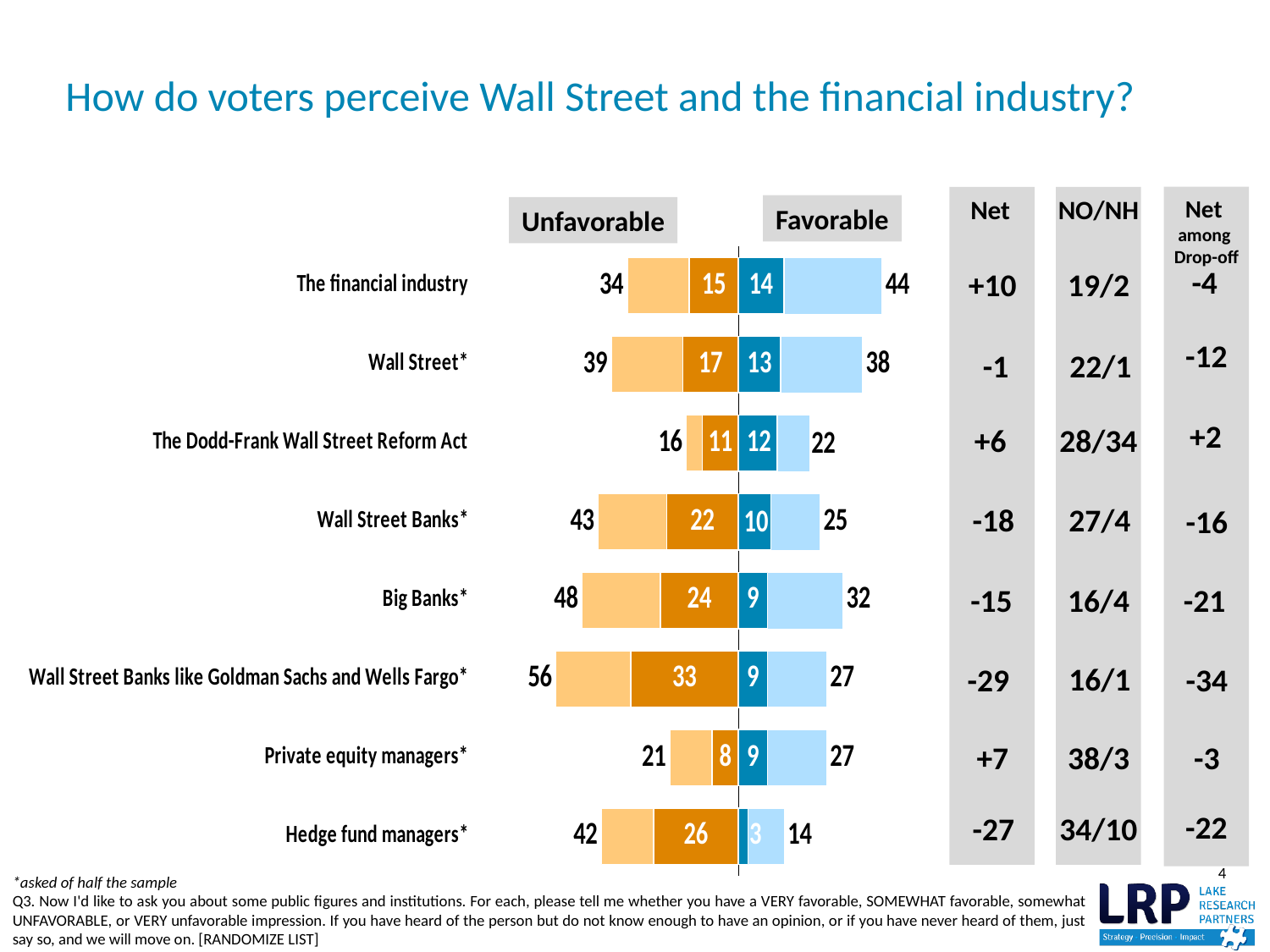
What is the Net value shown for Wall Street Banks*? -18 What is the total favorable value for The financial industry? 44 Which category has the highest total unfavorable value? Wall Street Banks like Goldman Sachs and Wells Fargo* Which category has the lowest total favorable value? Hedge fund managers* What is the very favorable (dark blue) value for Wall Street*? 13 What are the two column headings shown above the bars? Unfavorable and Favorable What kind of chart is shown on the slide? bar chart Which is larger for The Dodd-Frank Wall Street Reform Act: the total unfavorable value or the total favorable value? total favorable What is the difference between the total unfavorable and total favorable values for Big Banks*? 16 What is the very unfavorable (dark orange) value for Hedge fund managers*? 26 What is the total unfavorable value for Wall Street Banks like Goldman Sachs and Wells Fargo*? 56 How many categories are plotted in the chart? 8